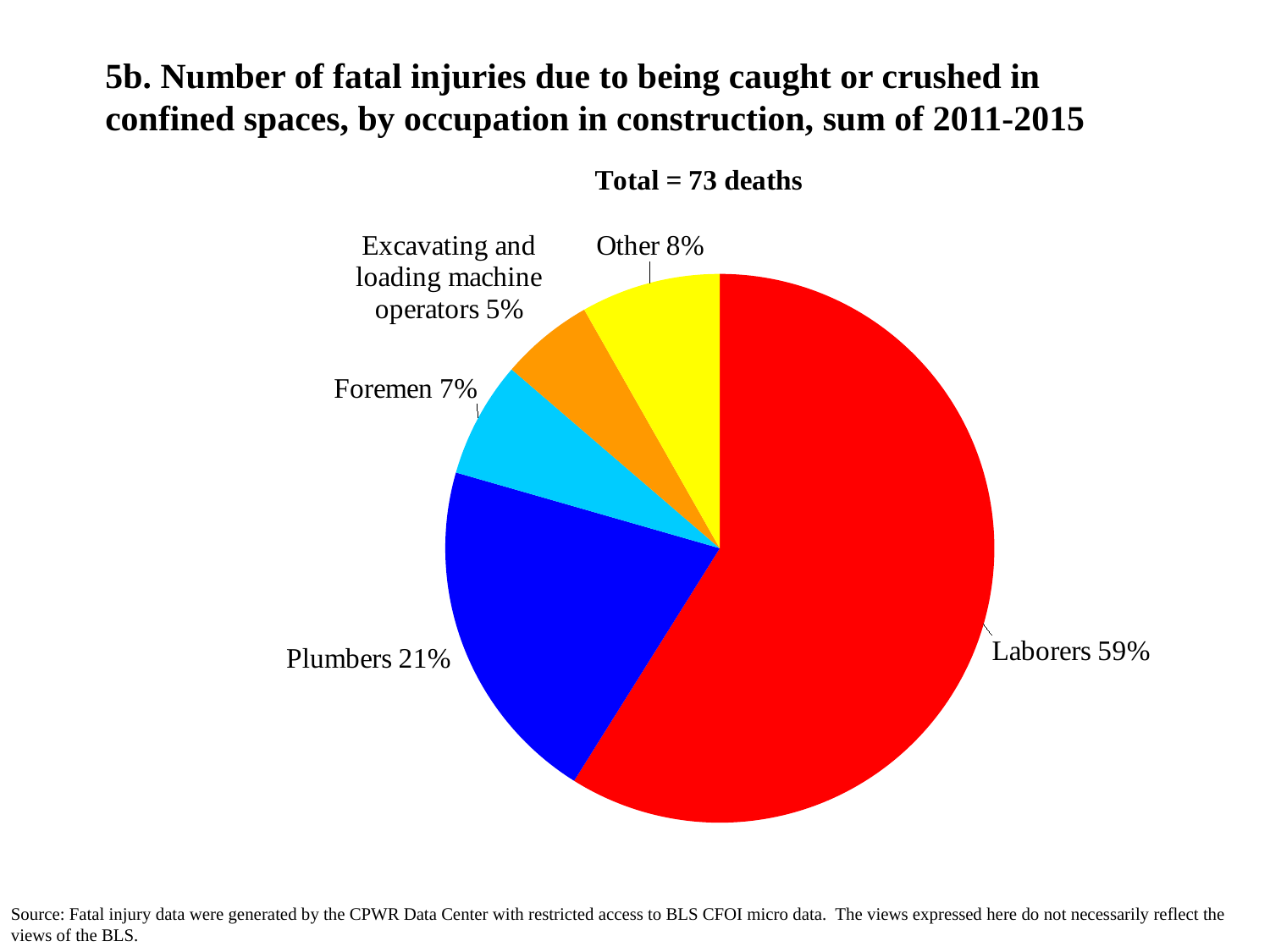
What share of fatal injuries is attributed to Laborers? 59% What is the difference in percentage points between the Laborers share and the Plumbers share? 38 percentage points What share of fatal injuries is attributed to Excavating and loading machine operators? 5% Which occupation has the smallest share of fatal injuries? Excavating and loading machine operators Which occupation has the largest share of fatal injuries? Laborers What kind of chart is shown on the slide? Pie chart How many slices does the pie chart have? 5 What share of fatal injuries is attributed to Foremen? 7% What total number of deaths does the chart represent? 73 deaths Which has a larger share, Foremen or Other? Other